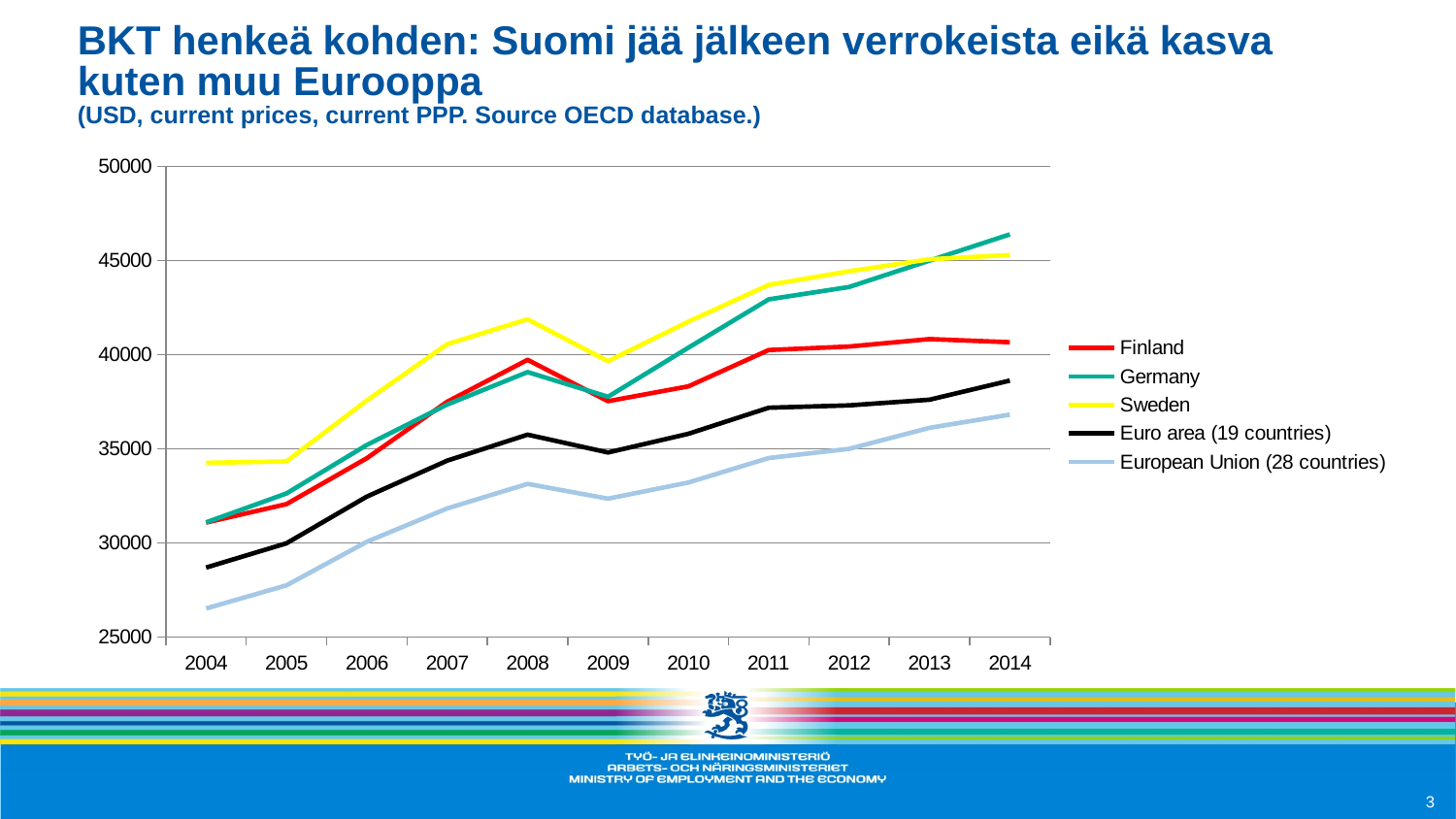
Is the value for Sweden in 2004 greater or less than 35000? less In 2008, which is larger: the value for Sweden or the value for Finland? Sweden Is the value for European Union (28 countries) in 2004 greater or less than 30000? less Does the value for Finland rise or fall from 2008 to 2009? fall Is the value for Germany in 2014 greater or less than 45000? greater How many years are shown on the x axis? 11 What kind of chart is shown on the slide? line chart Which series has the highest value in 2004? Sweden Which series has the highest value in 2014? Germany Which series has the lowest value in 2014? European Union (28 countries) How many series does the legend list? 5